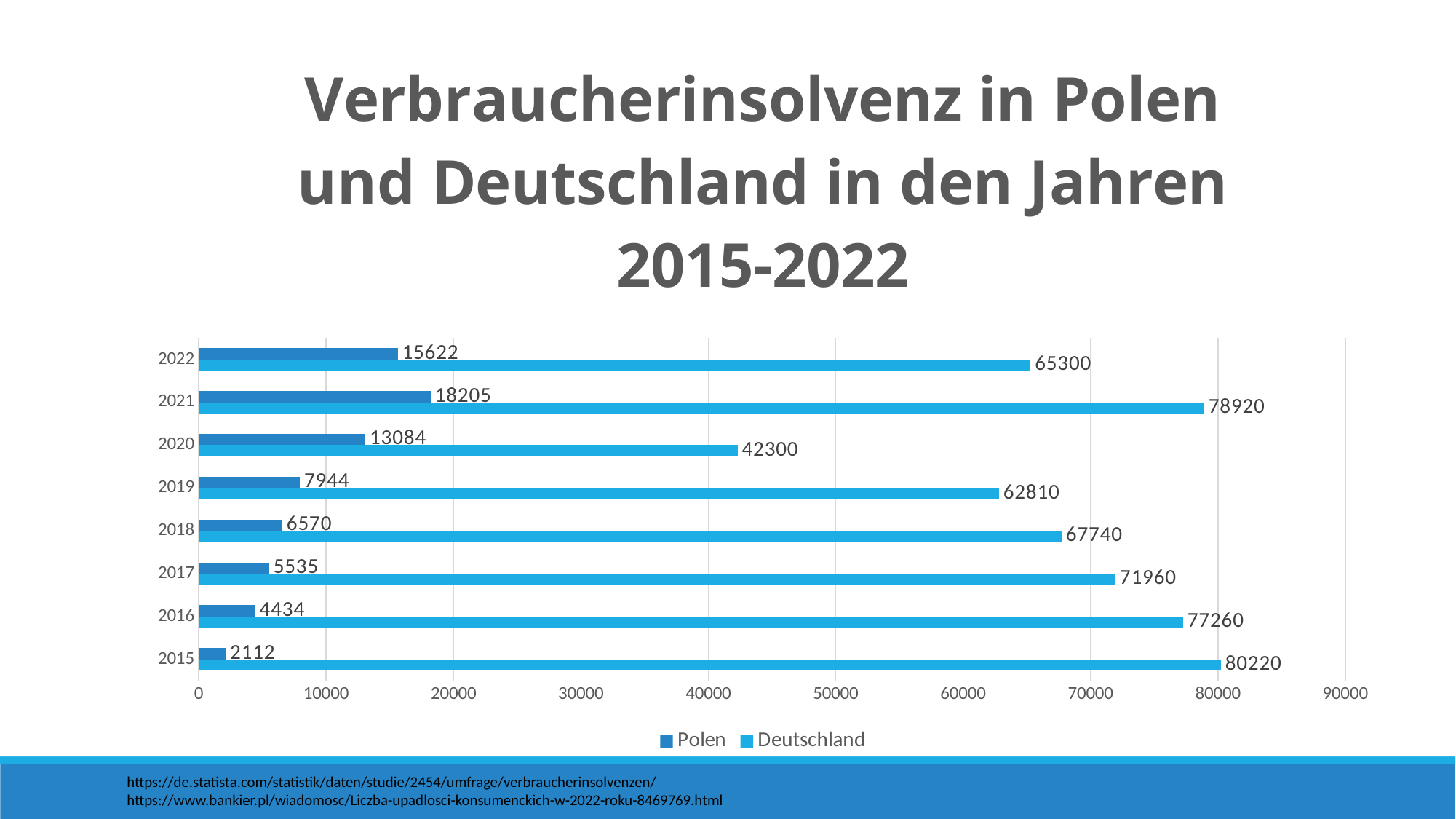
In which year is the Polen value lowest? 2015 How many years are shown on the chart? 8 Which series is shown in the darker blue colour? Polen In which year is the Deutschland value highest? 2015 What is the value for Polen in 2022? 15622 What is the value for Deutschland in 2020? 42300 What is the difference between the Deutschland and Polen values in 2021? 60715 Which is larger, the Deutschland value in 2019 or in 2022? 2022 What is the value for Deutschland in 2015? 80220 In which year is the Polen value highest? 2021 How many series does the legend list? 2 What kind of chart is shown on the slide? bar chart